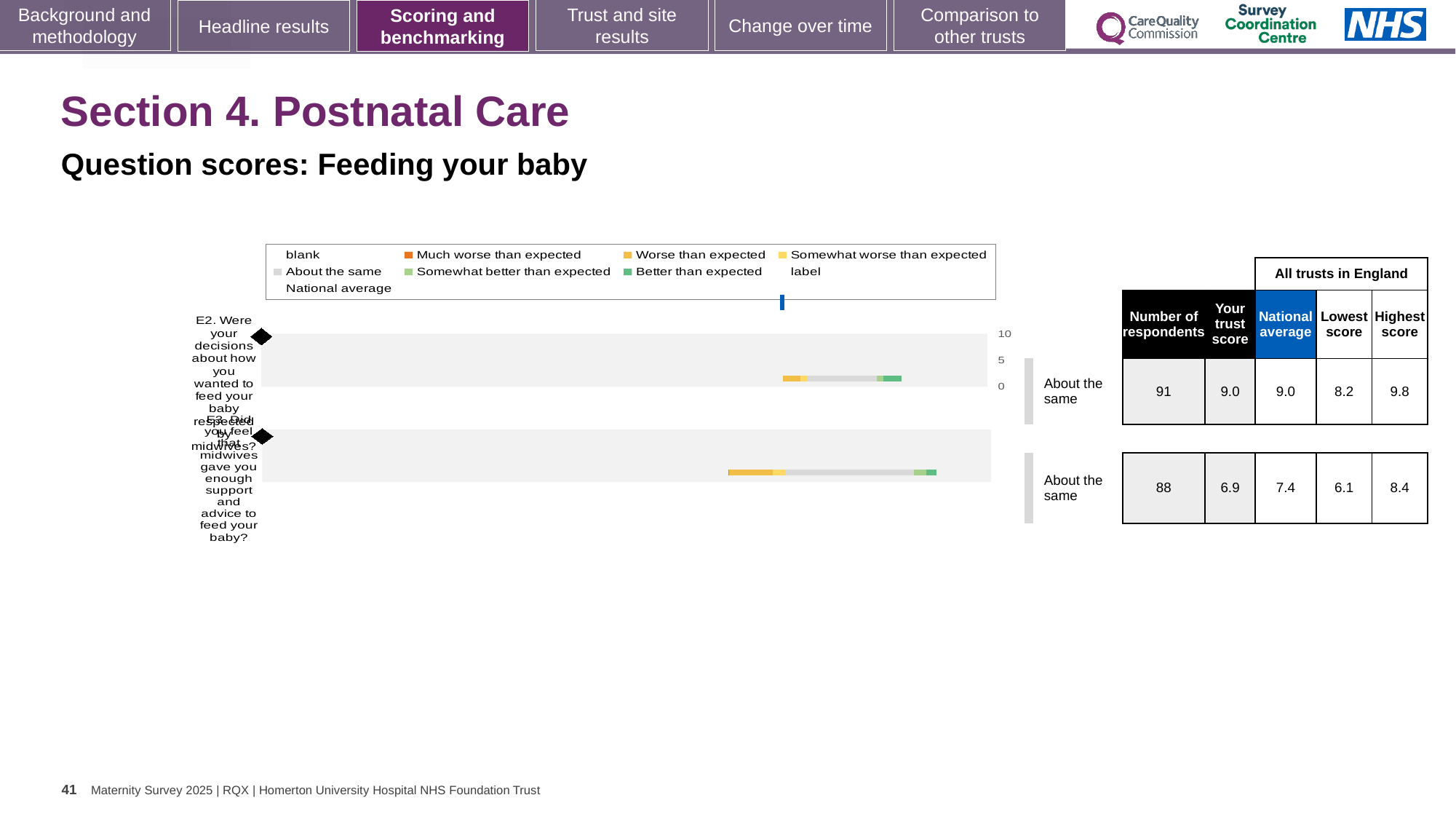
What benchmark category is shown for both questions E2 and E3? About the same What is the difference between the highest and lowest scores for question E2? 1.6 How many respondents answered question E2? 91 What is the national average for question E3? 7.4 Which question has the higher trust score, E2 or E3? E2 What kind of chart is used to show the question scores on this slide? bar chart What is the lowest score among all trusts in England for question E3? 6.1 How many questions (categories) are plotted in the chart? 2 What is the trust score for question E3 (midwives gave you enough support and advice to feed your baby)? 6.9 By how much is the national average for question E3 higher than the trust score? 0.5 What is the trust score for question E2 (decisions about how you wanted to feed your baby respected by midwives)? 9.0 What is the highest score among all trusts in England for question E2? 9.8